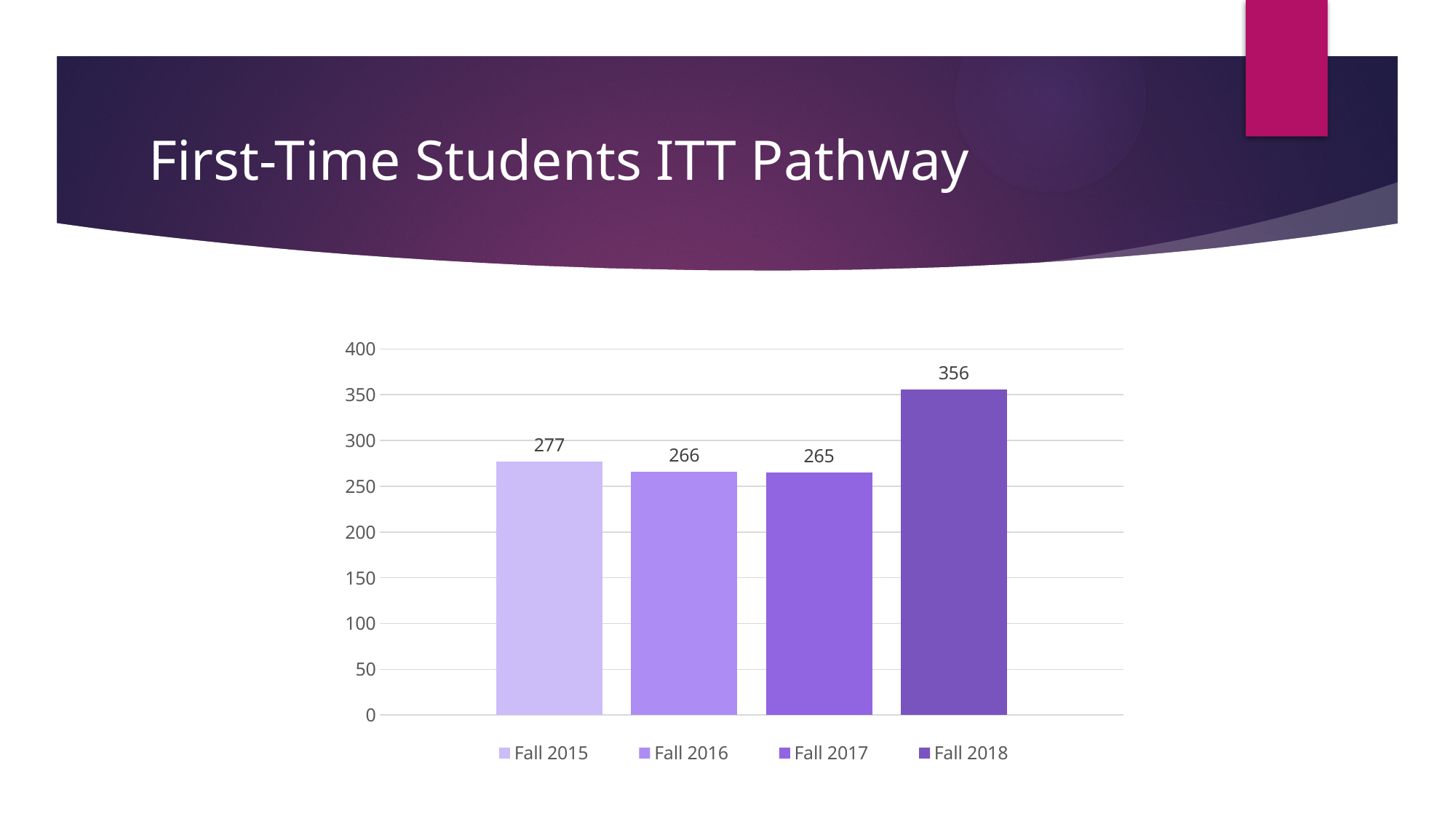
What is the difference between the values for Fall 2015 and Fall 2016? 11 What kind of chart is shown on the slide? bar chart Which term has the highest value? Fall 2018 Is the value for Fall 2018 greater or less than 300? greater What is the value for Fall 2015? 277 What is the difference between the values for Fall 2018 and Fall 2015? 79 What is the value for Fall 2017? 265 What is the value for Fall 2016? 266 How many entries does the legend list? 4 What is the value for Fall 2018? 356 Which is larger, the value for Fall 2015 or the value for Fall 2018? Fall 2018 How many bars are shown in the chart? 4